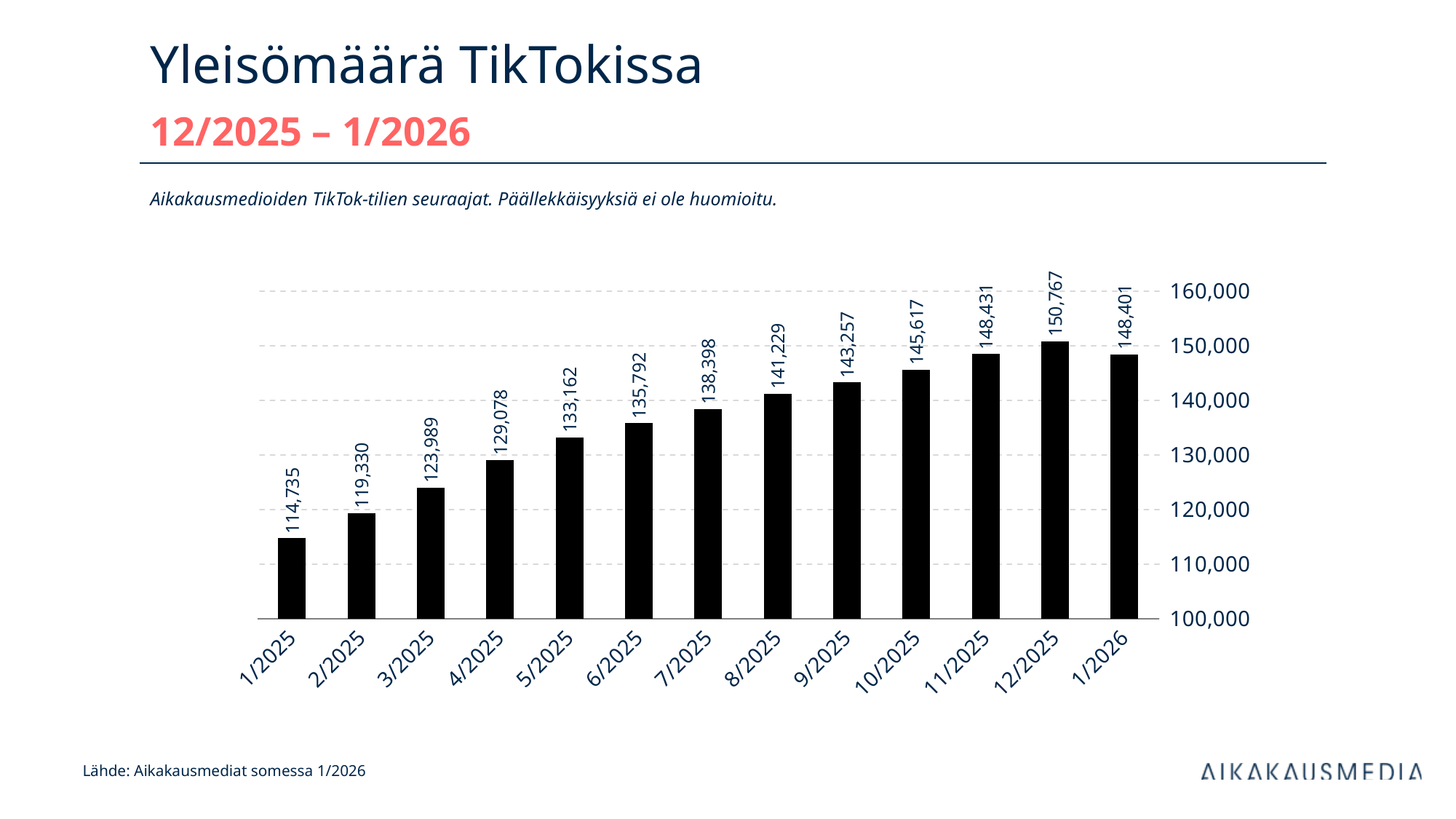
Which month has the highest value? 12/2025 What is the difference between the values for 12/2025 and 1/2026? 2,366 What kind of chart is shown on the slide? Bar chart What is the difference between the values for 1/2026 and 1/2025? 33,666 What is the value for 1/2025? 114,735 Do the values rise or fall from 1/2025 to 12/2025? Rise Which month has the lowest value? 1/2025 How many months are shown on the x axis? 13 What is the value for 6/2025? 135,792 What is the value for 1/2026? 148,401 What is the value for 12/2025? 150,767 Which is larger, the value for 4/2025 or the value for 8/2025? 8/2025